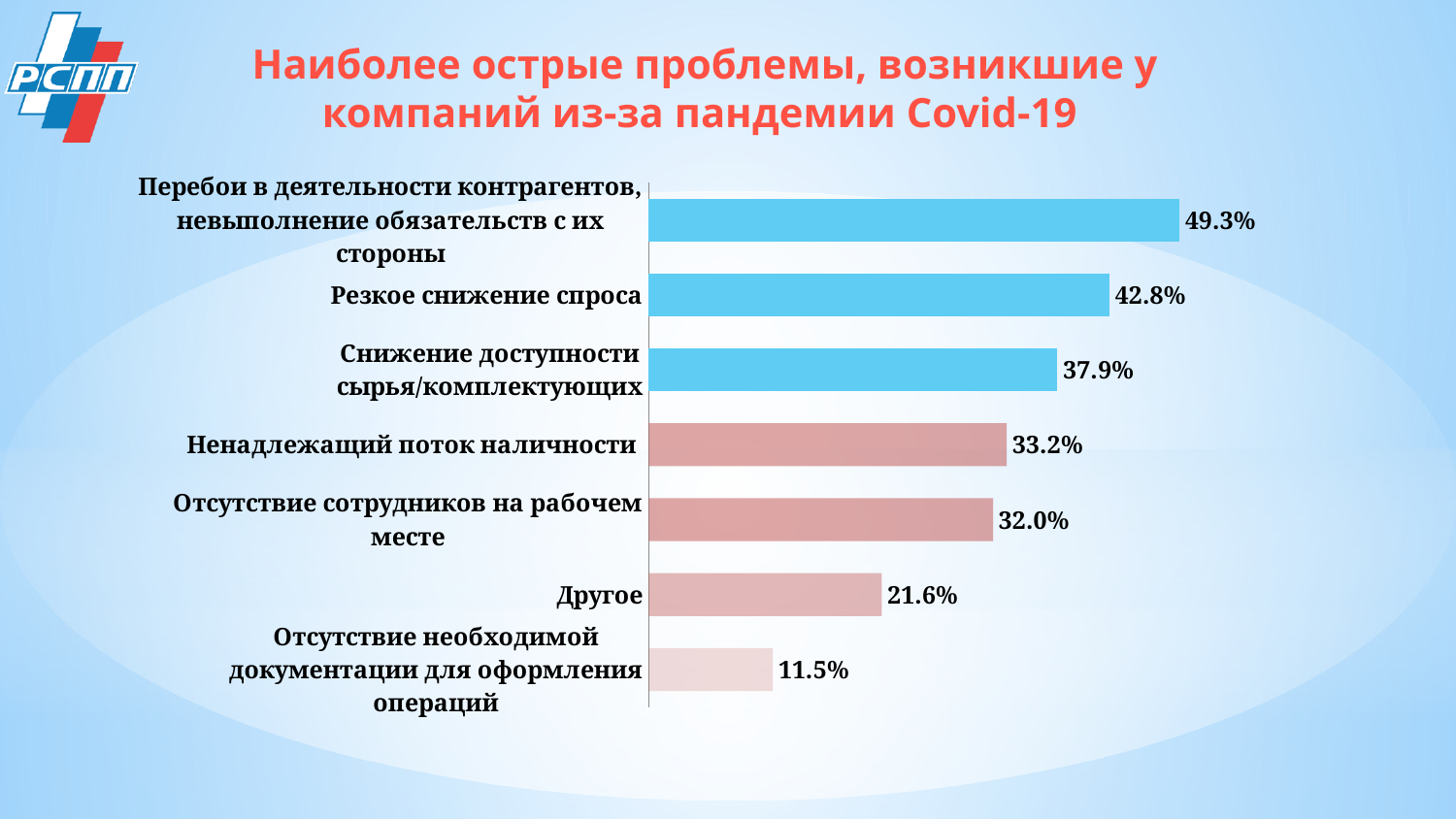
What is the difference between the values for "Другое" and "Отсутствие необходимой документации для оформления операций"? 10.1% What is the title of the slide? Наиболее острые проблемы, возникшие у компаний из-за пандемии Covid-19 Which category has the highest value? Перебои в деятельности контрагентов, невыполнение обязательств с их стороны What is the value for "Отсутствие сотрудников на рабочем месте"? 32.0% What is the difference between the values for "Резкое снижение спроса" and "Снижение доступности сырья/комплектующих"? 4.9% What is the value for "Резкое снижение спроса"? 42.8% Which category has the lowest value? Отсутствие необходимой документации для оформления операций What is the value for "Ненадлежащий поток наличности"? 33.2% What is the value for "Другое"? 21.6% How many categories are shown in the chart? 7 Which is larger: the value for "Ненадлежащий поток наличности" or the value for "Другое"? Ненадлежащий поток наличности What kind of chart is shown on the slide? Bar chart